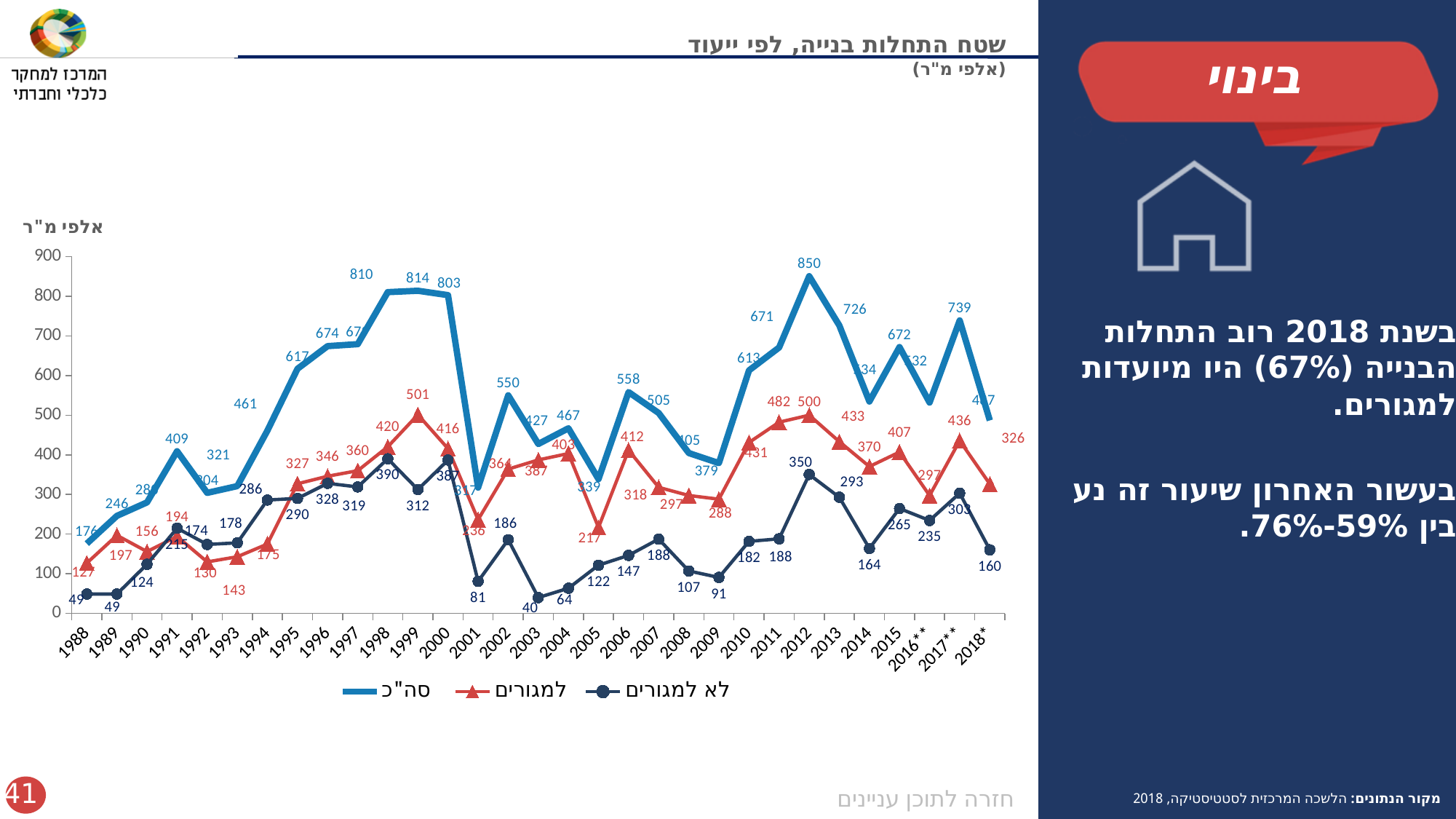
In which year does the לא למגורים series reach its lowest value? 2003 Is the סה"כ value for 2001 greater or less than 400? less How many series does the legend list? 3 In 2018*, which is larger: the למגורים value or the לא למגורים value? למגורים What is the value of the סה"כ series in 2012? 850 What is the value of the לא למגורים series in 2003? 40 What is the value of the למגורים series in 1999? 501 What is the difference between the למגורים values in 2012 and 2018*? 174 Does the סה"כ series rise or fall from 2012 to 2014? fall What kind of chart is shown on the slide? line chart How many years are shown on the x axis? 31 In which year does the סה"כ series reach its highest value? 2012